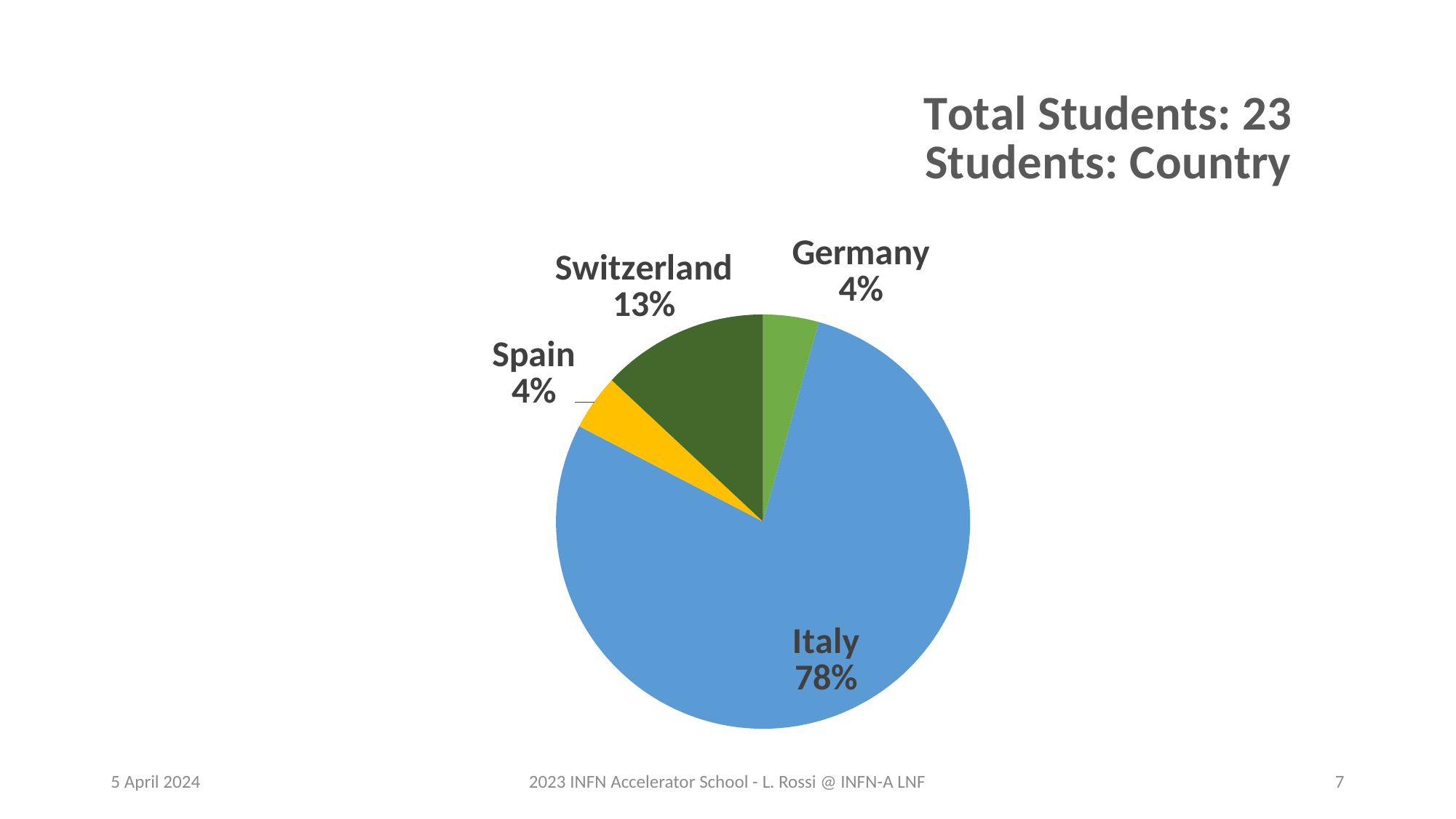
Which country has the largest share of students? Italy What share of students is from Spain? 4% What share of students is from Switzerland? 13% What is the difference in percentage points between Italy's share and Switzerland's share? 65 What kind of chart is shown on the slide? pie chart What share of students is from Italy? 78% Which has a larger share of students, Switzerland or Spain? Switzerland What share of students is from Germany? 4% What is the combined share of Spain and Germany? 8% What is the total number of students stated on the slide? 23 How many countries are shown in the pie chart? 4 What colour is the slice for Italy? blue